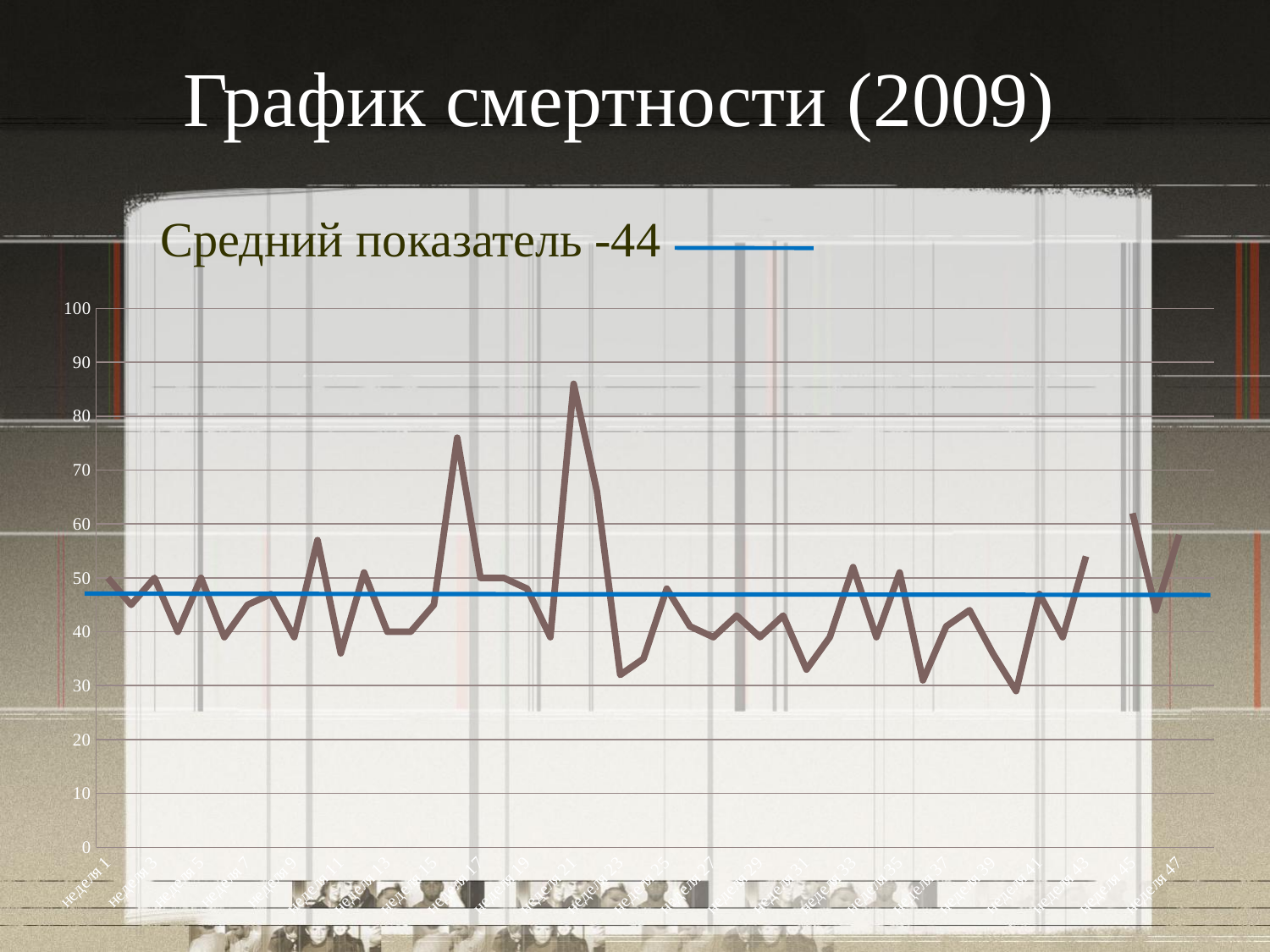
Which is larger, the value for неделя 21 or the value for неделя 17? неделя 21 What average value (Средний показатель) is stated on the slide? 44 Is the value for неделя 17 greater or less than 70? less Is the value for неделя 21 greater or less than 80? greater What kind of chart is shown on the slide? line chart Is the value for неделя 45 greater or less than 50? greater What is the highest value shown on the vertical axis? 100 At which week does the line reach its highest value? неделя 21 What is the title of the slide's chart? График смертности (2009) Which is larger, the value for неделя 23 or the value for неделя 25? неделя 25